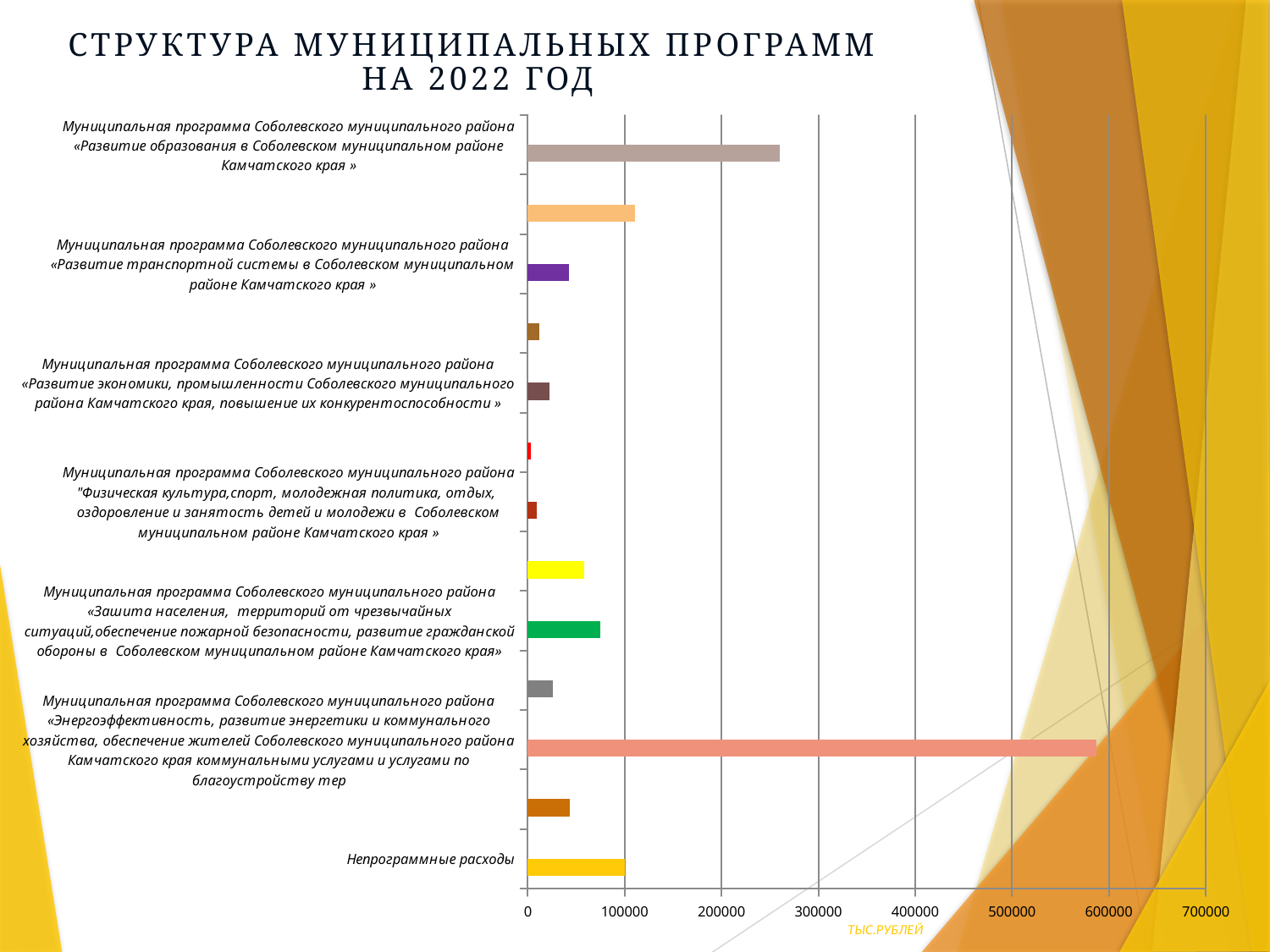
Is the value of the longest bar in the chart greater or less than 500000? greater What unit is shown under the horizontal axis of the chart? ТЫС.РУБЛЕЙ What is the title of the slide's chart? СТРУКТУРА МУНИЦИПАЛЬНЫХ ПРОГРАММ НА 2022 ГОД Is the value for the programme «Развитие образования в Соболевском муниципальном районе Камчатского края» greater or less than 300000? less Is the value for the programme «Развитие образования в Соболевском муниципальном районе Камчатского края» greater or less than 200000? greater Which is larger: the value for «Развитие образования в Соболевском муниципальном районе Камчатского края» or the value for «Непрограммные расходы»? Развитие образования в Соболевском муниципальном районе Камчатского края What is the highest value shown on the horizontal axis of the chart? 700000 How many bars are plotted in the chart? 13 What kind of chart is shown on the slide? bar chart